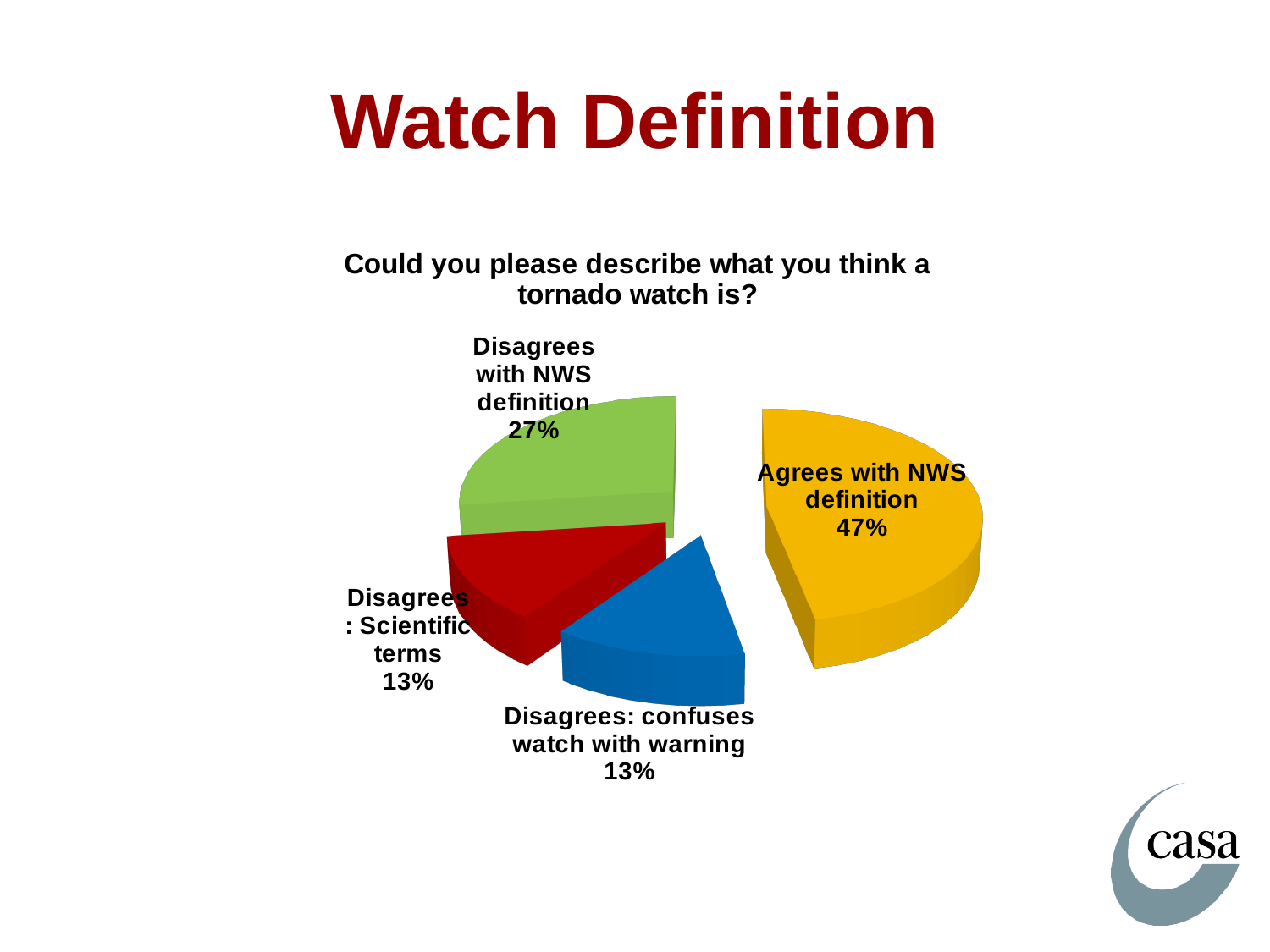
What percentage of respondents disagree with the NWS definition? 27% What type of chart is shown on the slide? Pie chart How many slices does the pie chart have? 4 Which is larger: 'Disagrees with NWS definition' or 'Disagrees: confuses watch with warning'? Disagrees with NWS definition What percentage of respondents agree with the NWS definition? 47% What colour is the 'Agrees with NWS definition' slice? Yellow What is the chart's title? Could you please describe what you think a tornado watch is? What is the combined share of the three 'Disagrees' categories? 53% What share is labelled 'Disagrees: confuses watch with warning'? 13% What is the difference in percentage points between 'Agrees with NWS definition' and 'Disagrees with NWS definition'? 20 percentage points Which category has the largest slice of the pie? Agrees with NWS definition What share is labelled 'Disagrees: Scientific terms'? 13%